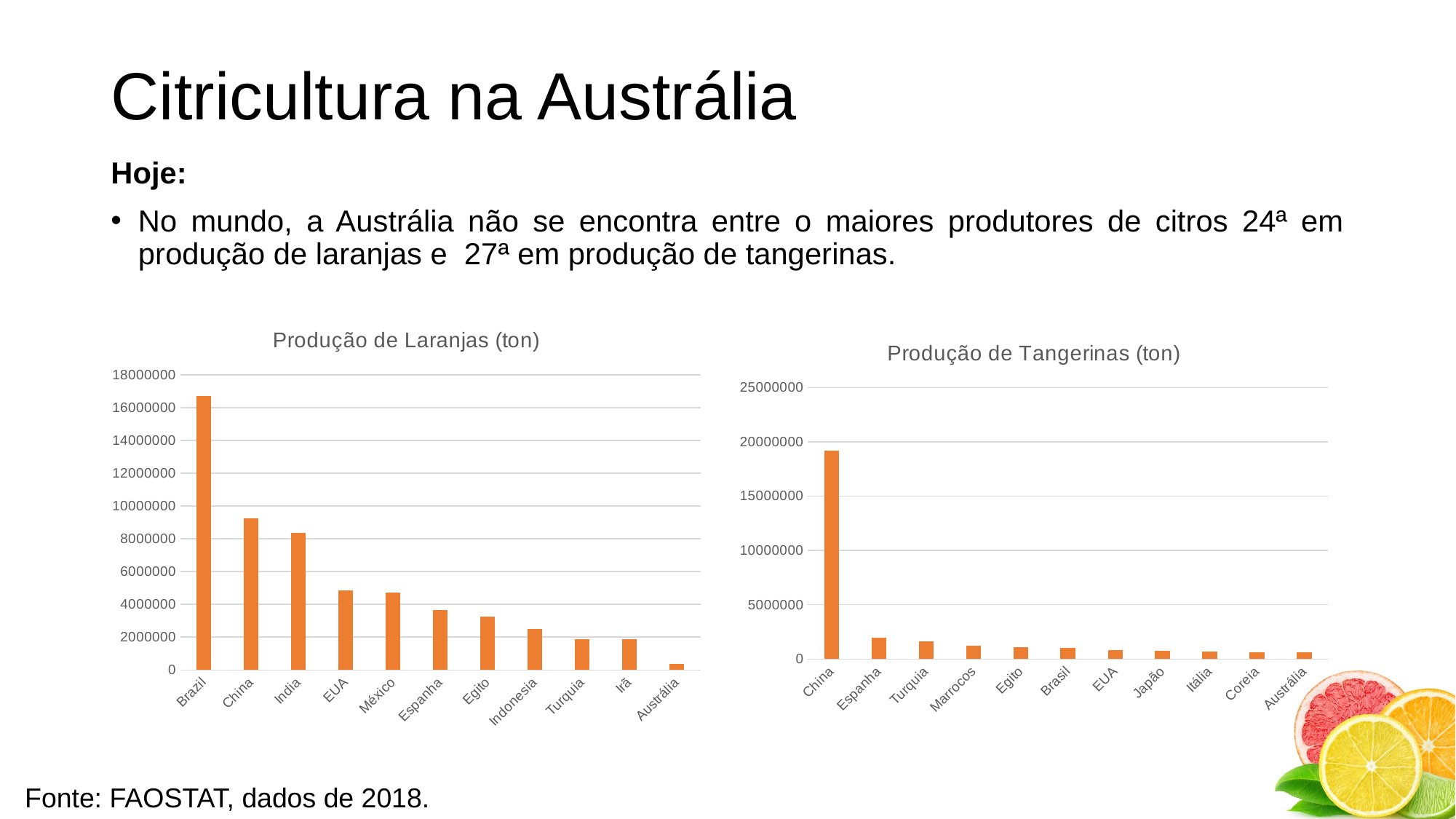
How many countries are shown in the 'Produção de Tangerinas (ton)' chart? 11 In the 'Produção de Laranjas (ton)' chart, which country has the lowest orange production? Austrália In the 'Produção de Laranjas (ton)' chart, which is larger, the value for China or the value for India? China In the 'Produção de Tangerinas (ton)' chart, do the values rise or fall from left to right along the x axis? Fall What kind of chart is the 'Produção de Laranjas (ton)' chart? Bar chart In the 'Produção de Tangerinas (ton)' chart, is the value for China greater or less than 20000000? less In the 'Produção de Laranjas (ton)' chart, is the value for Brazil greater or less than 16000000? greater In the 'Produção de Tangerinas (ton)' chart, is the value for Espanha greater or less than 5000000? less In the 'Produção de Tangerinas (ton)' chart, which country has the highest tangerine production? China In the 'Produção de Laranjas (ton)' chart, which country has the highest orange production? Brazil